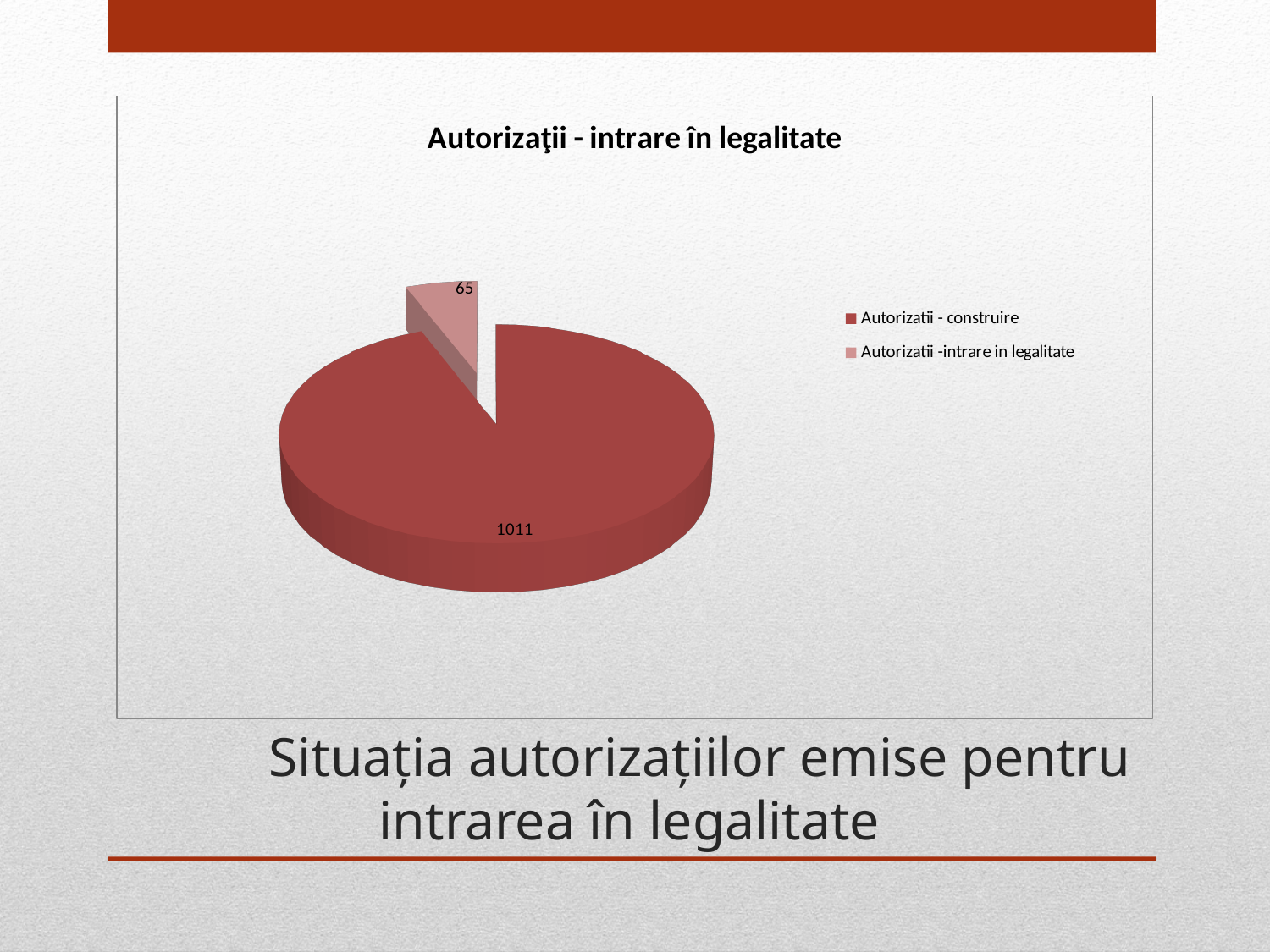
What type of chart is shown on the slide? pie chart What is the total of the two values shown in the pie chart? 1076 What is the difference between the value for Autorizatii - construire and the value for Autorizatii -intrare in legalitate? 946 What is the title of the chart? Autorizaţii - intrare în legalitate Which category has the smallest slice of the pie? Autorizatii -intrare in legalitate Which category has the largest slice of the pie? Autorizatii - construire How many slices does the pie chart have? 2 Which is larger, the value for Autorizatii - construire or the value for Autorizatii -intrare in legalitate? Autorizatii - construire What is the value for Autorizatii - construire? 1011 What is the value for Autorizatii -intrare in legalitate? 65 To the nearest whole percent, what share of the pie does Autorizatii -intrare in legalitate represent? 6% How many entries does the legend list? 2